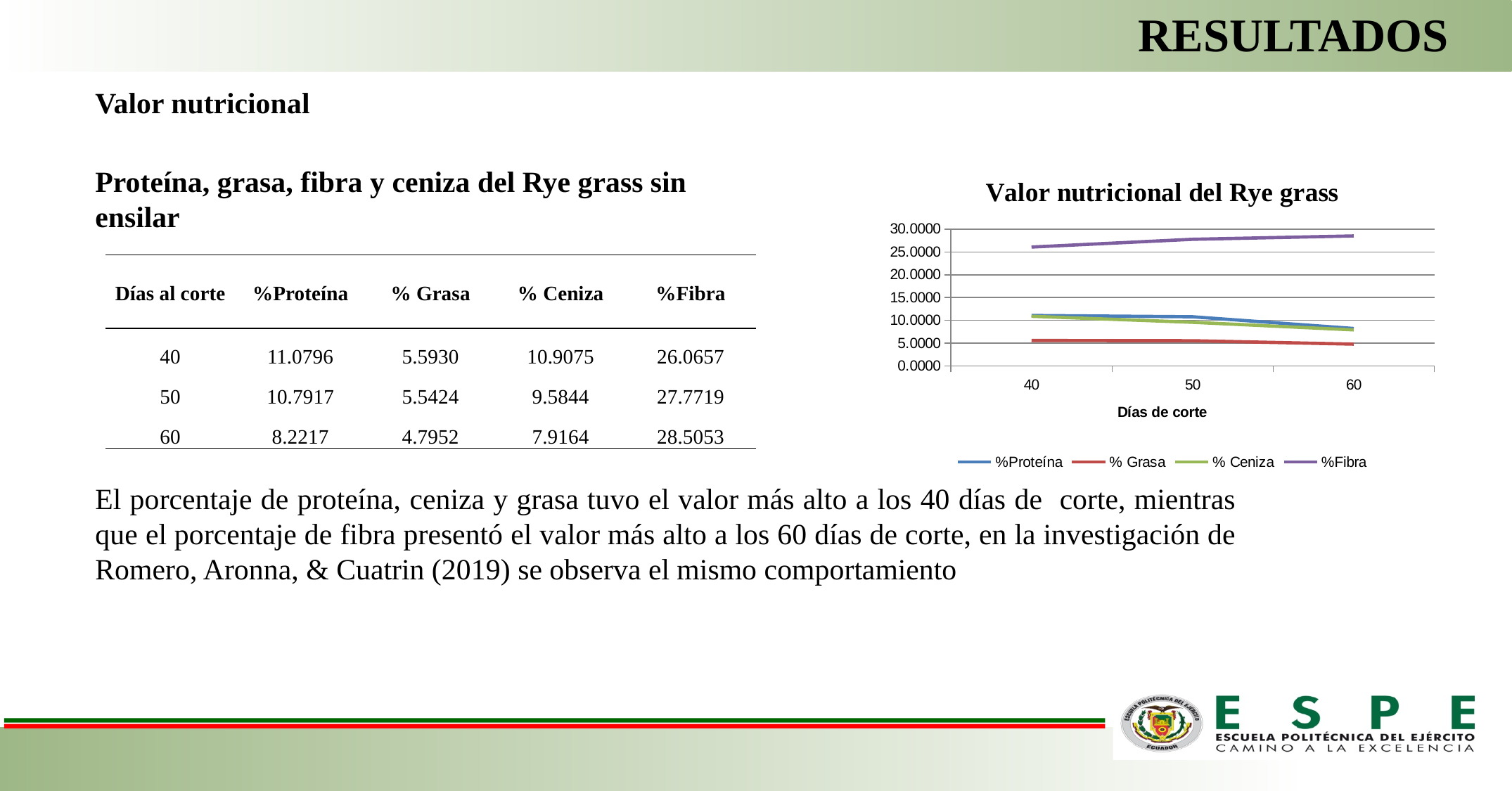
According to the slide, what is the %Fibra value at 60 días al corte plotted in the "Valor nutricional del Rye grass" chart? 28.5053 What is the title of the line chart on the slide? Valor nutricional del Rye grass How many points on the x axis (Días de corte) does the "Valor nutricional del Rye grass" chart show? 3 According to the slide, what is the %Proteína value at 40 días al corte plotted in the "Valor nutricional del Rye grass" chart? 11.0796 In the "Valor nutricional del Rye grass" chart, which series has the highest values at every cutting day? %Fibra In the "Valor nutricional del Rye grass" chart, which series has the lowest values at every cutting day? % Grasa In the "Valor nutricional del Rye grass" chart, is the value of %Fibra at 60 días de corte greater or less than 25.0000? greater In the "Valor nutricional del Rye grass" chart, does %Proteína rise or fall from 40 to 60 días de corte? fall How many series does the legend of the "Valor nutricional del Rye grass" chart list? 4 In the "Valor nutricional del Rye grass" chart, is the value of % Grasa at 40 días de corte greater or less than 10.0000? less In the "Valor nutricional del Rye grass" chart, does %Fibra rise or fall from 40 to 60 días de corte? rise What kind of chart is "Valor nutricional del Rye grass"? line chart